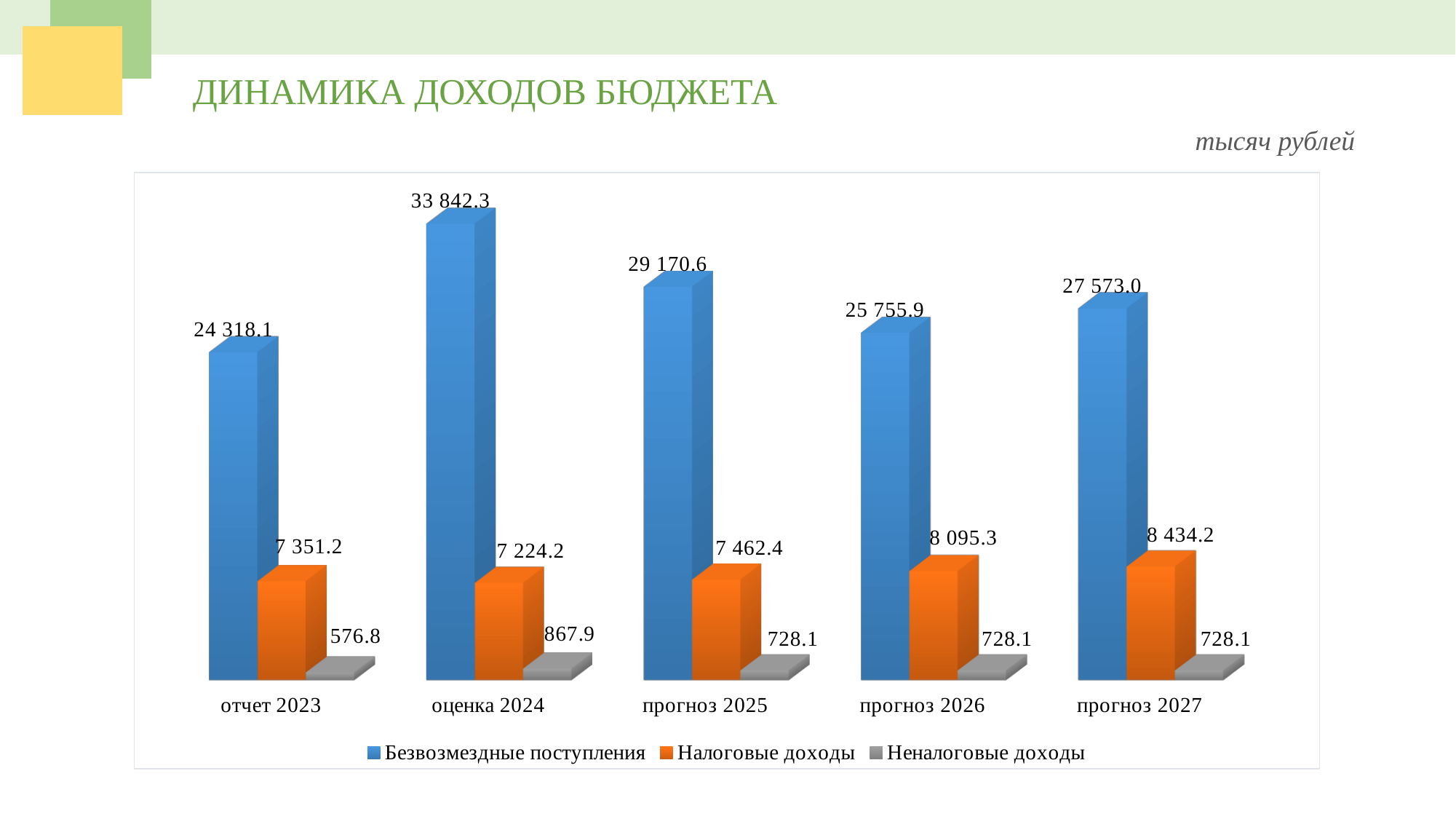
What is the value of Безвозмездные поступления for оценка 2024? 33 842.3 How many series does the legend list? 3 How many categories are shown on the x axis? 5 What is the value of Налоговые доходы for прогноз 2027? 8 434.2 What is the difference between Безвозмездные поступления for оценка 2024 and for отчет 2023? 9 524.2 In which category is Безвозмездные поступления highest? оценка 2024 What is the difference between Неналоговые доходы for оценка 2024 and for отчет 2023? 291.1 In which category is Налоговые доходы lowest? оценка 2024 What kind of chart is shown on the slide? bar chart What is the value of Неналоговые доходы for отчет 2023? 576.8 Which is larger: Налоговые доходы for прогноз 2026 or for прогноз 2025? прогноз 2026 From прогноз 2025 to прогноз 2027, do the values for Налоговые доходы rise or fall? rise